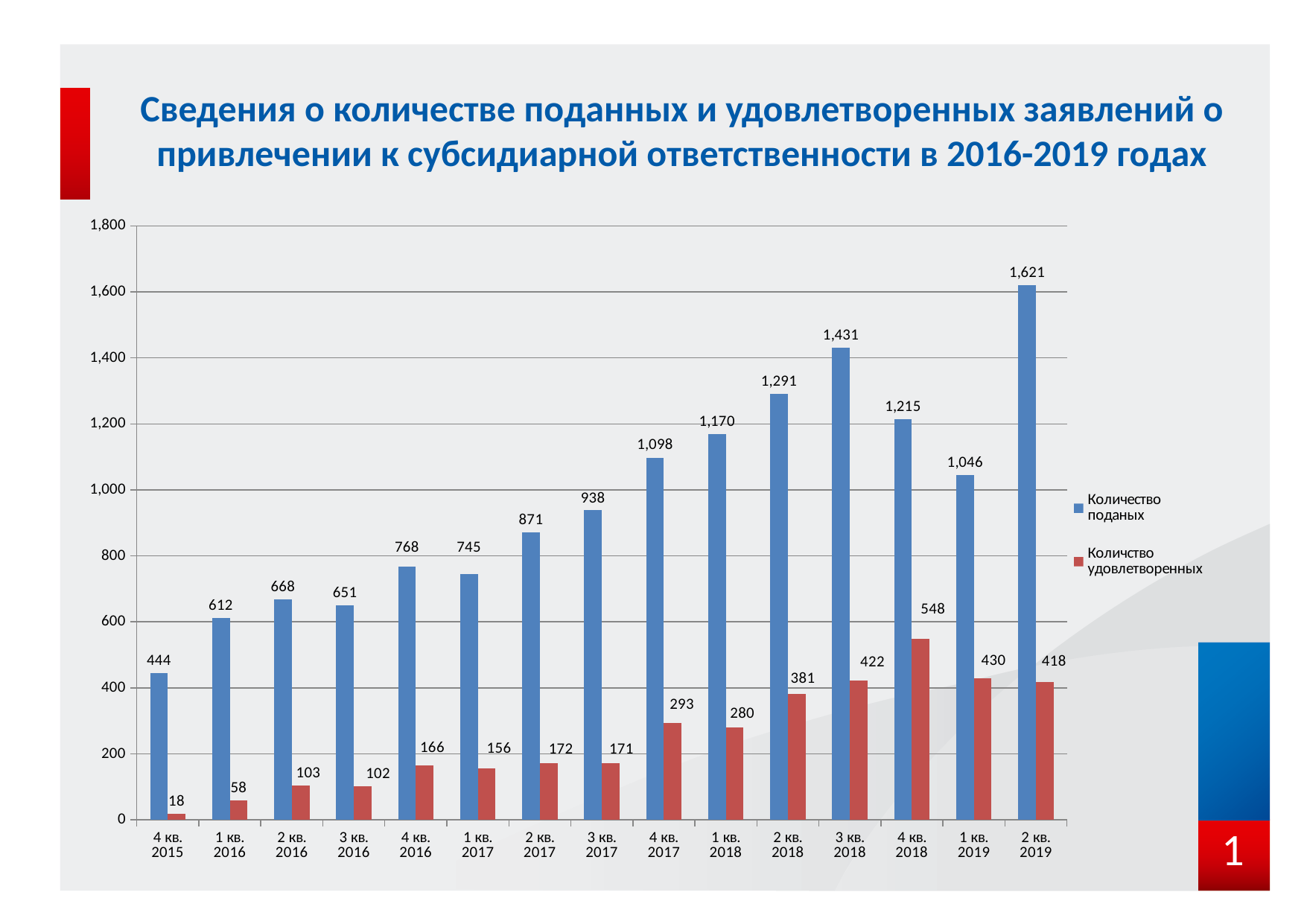
How many quarters are shown on the x axis? 15 What kind of chart is shown on the slide? Bar chart Which quarter has the lowest value for "Количство удовлетворенных"? 4 кв. 2015 Which quarter has the highest value for "Количество поданых"? 2 кв. 2019 How many series does the legend list? 2 Which colour represents "Количство удовлетворенных" in the chart? Red Which is larger: "Количество поданых" in 4 кв. 2018 or in 1 кв. 2019? 4 кв. 2018 What is the value of "Количество поданых" for 3 кв. 2017? 938 What is the value of "Количество поданых" for 2 кв. 2019? 1,621 What is the difference between "Количество поданых" and "Количство удовлетворенных" in 3 кв. 2018? 1,009 What is the value of "Количство удовлетворенных" for 4 кв. 2018? 548 Does "Количество поданых" rise or fall from 4 кв. 2015 to 3 кв. 2018? Rise